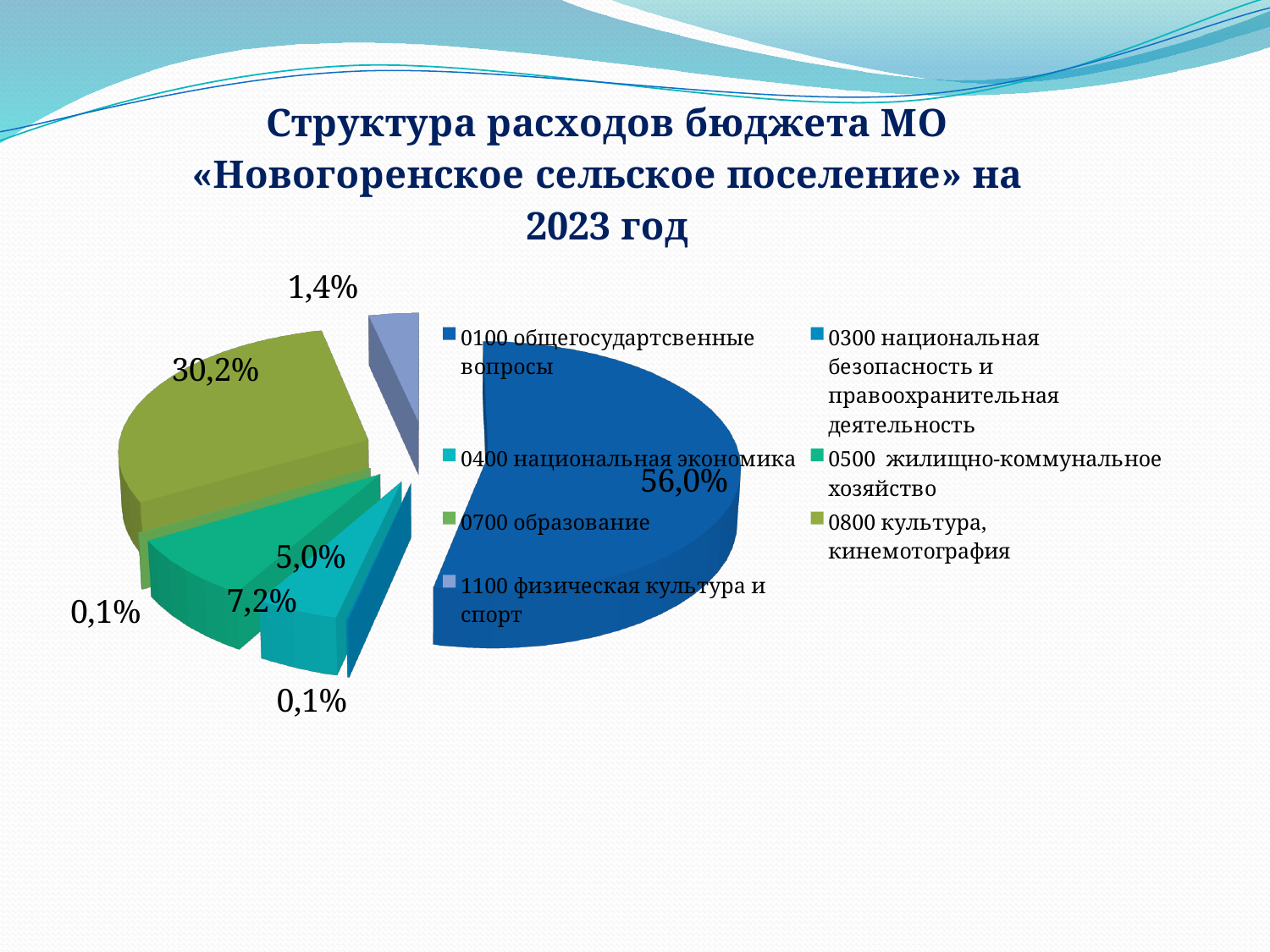
Which category has the largest slice of the pie? 0100 общегосударственные вопросы Which has a larger share: "0400 национальная экономика" or "0500 жилищно-коммунальное хозяйство"? 0500 жилищно-коммунальное хозяйство What kind of chart is shown on the slide? pie chart What share of the budget expenditure goes to "0800 культура, кинемотография"? 30,2% What share of the budget expenditure goes to "0500 жилищно-коммунальное хозяйство"? 7,2% What share of the budget expenditure goes to "0100 общегосударственные вопросы"? 56,0% What share of the budget expenditure goes to "0400 национальная экономика"? 5,0% What share of the budget expenditure goes to "1100 физическая культура и спорт"? 1,4% What is the smallest percentage value shown on the pie chart? 0,1% For which year does the chart show the budget expenditure structure? 2023 How many categories does the legend of the pie chart list? 7 What is the difference between the shares of "0100 общегосударственные вопросы" and "0800 культура, кинемотография"? 25,8%